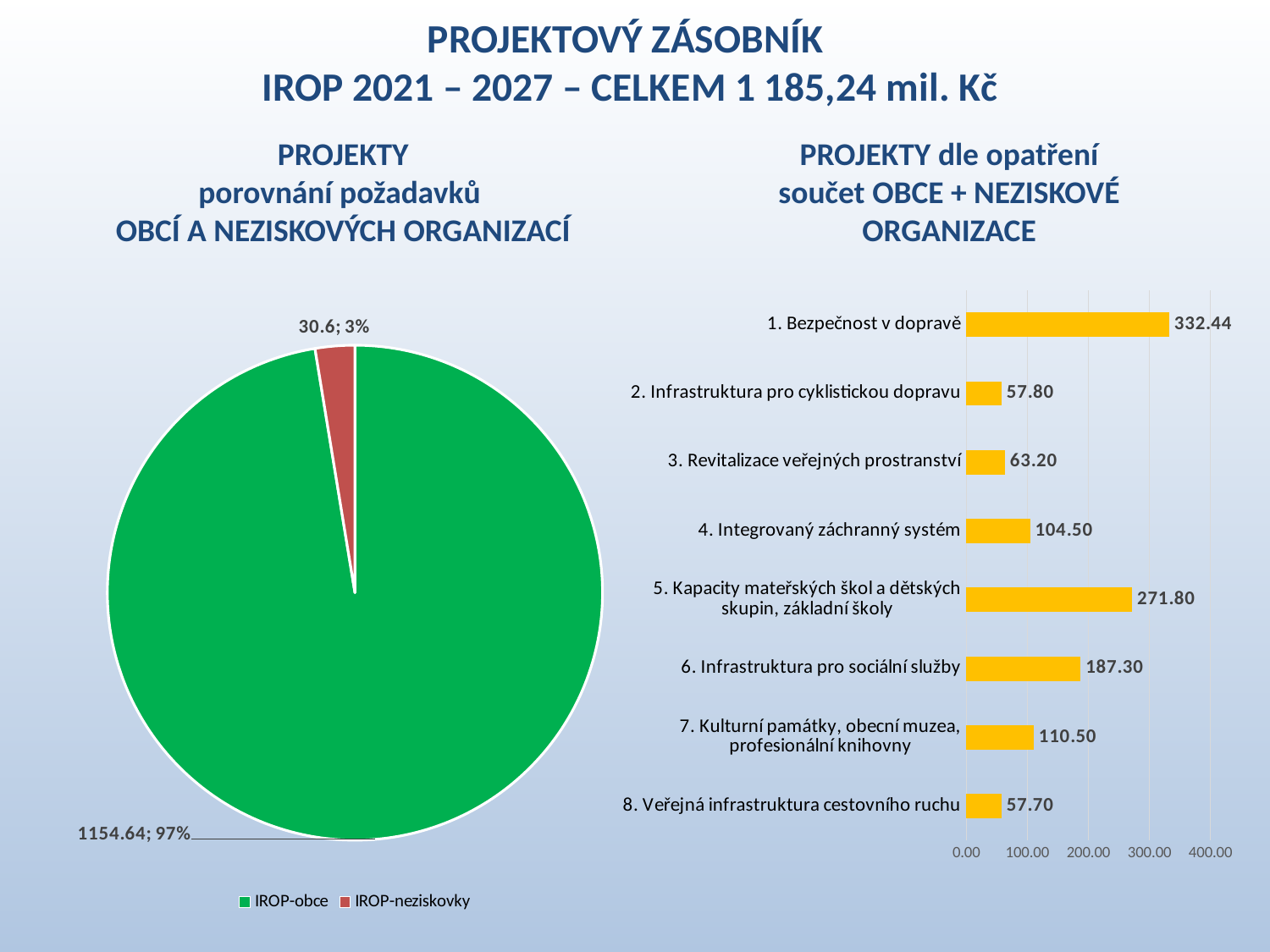
What type of chart is the chart on the left of the slide? pie chart In the bar chart on the right, what is the difference between '6. Infrastruktura pro sociální služby' and '4. Integrovaný záchranný systém'? 82.80 In the bar chart on the right, how many categories are shown? 8 In the pie chart on the left, what is the value shown for IROP-obce? 1154.64 How many series does the legend of the pie chart on the left list? 2 In the bar chart on the right, which category has the lowest value? 8. Veřejná infrastruktura cestovního ruchu In the bar chart on the right, what is the value for '5. Kapacity mateřských škol a dětských skupin, základní školy'? 271.80 What type of chart is the chart on the right of the slide? bar chart In the bar chart on the right, what is the value for '1. Bezpečnost v dopravě'? 332.44 In the bar chart on the right, which is larger: '3. Revitalizace veřejných prostranství' or '7. Kulturní památky, obecní muzea, profesionální knihovny'? 7. Kulturní památky, obecní muzea, profesionální knihovny In the pie chart on the left, what share of the pie does IROP-neziskovky represent? 3% In the bar chart on the right, which category has the highest value? 1. Bezpečnost v dopravě